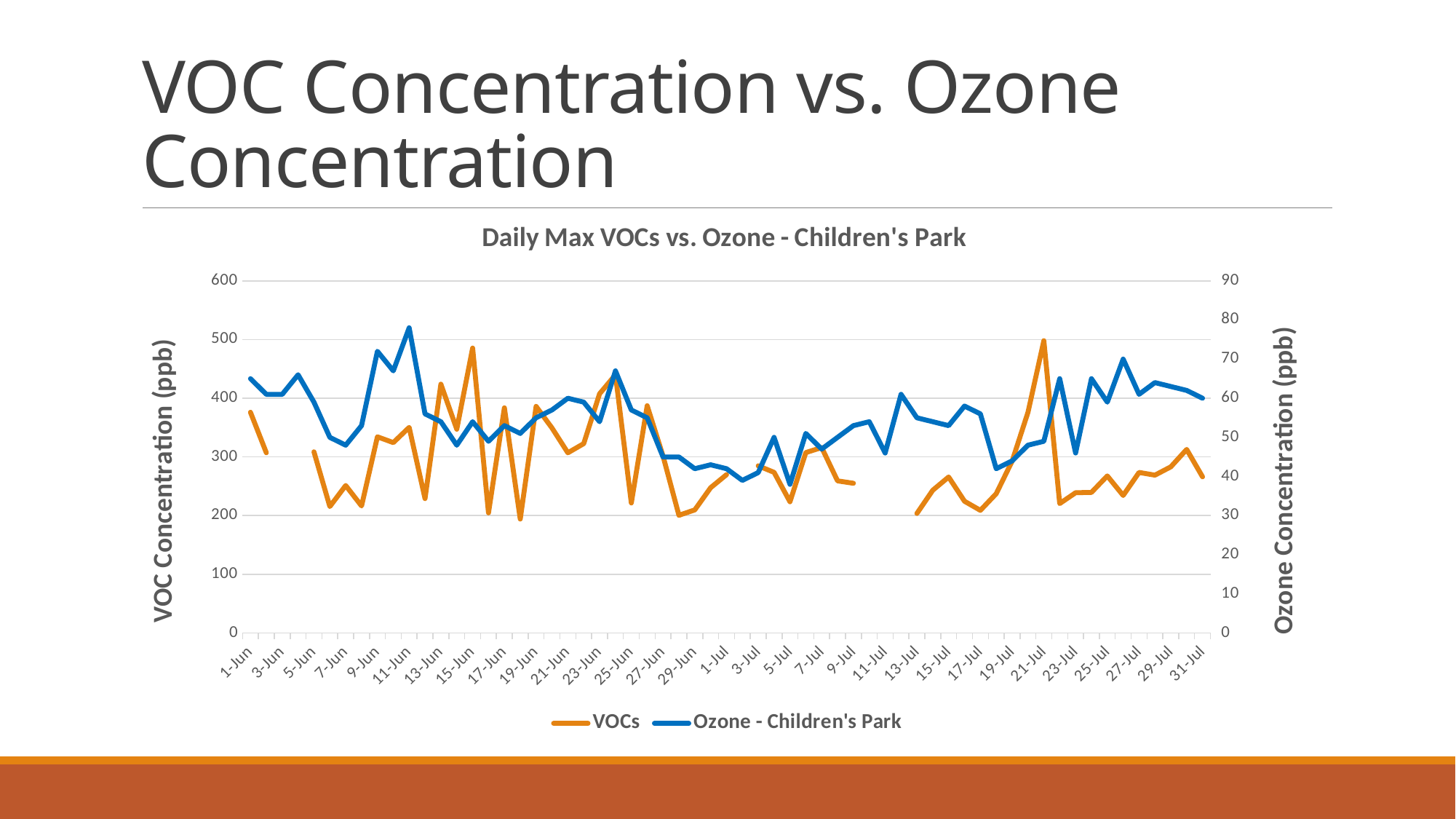
How many series does the legend list? 2 Does the Ozone - Children's Park series rise or fall between 5-Jul and 11-Jul? rise On which date does the VOCs series reach its highest value? 21-Jul Is the VOCs value on 29-Jun greater or less than 300? less Is the Ozone - Children's Park value on 11-Jun greater or less than 70? greater On which date does the Ozone - Children's Park series reach its highest value? 11-Jun What is the title of the chart? Daily Max VOCs vs. Ozone - Children's Park Is the Ozone - Children's Park value on 19-Jul greater or less than 50? less What kind of chart is shown on the slide? Line chart Which is larger for the VOCs series: the value on 21-Jul or the value on 29-Jun? 21-Jul What is the label of the right-hand vertical axis? Ozone Concentration (ppb)